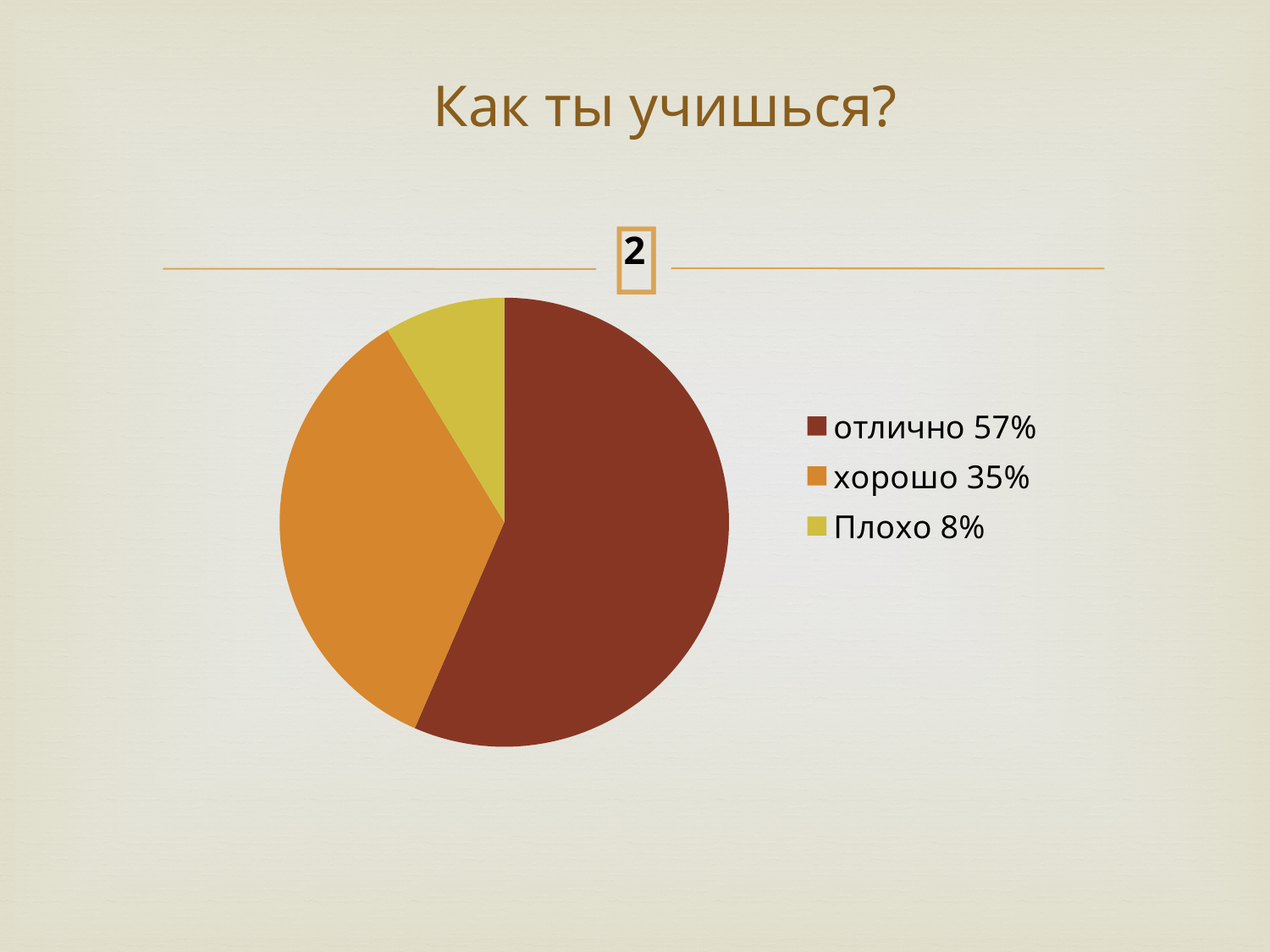
What colour is the slice for "Плохо"? yellow What is the difference in percentage points between "отлично" and "хорошо"? 22 How many slices does the pie chart have? 3 Which category has the smallest share of the pie? Плохо Which is larger, the share for "хорошо" or the share for "Плохо"? хорошо What percentage is shown for "отлично"? 57% What is the title of the slide containing the pie chart? Как ты учишься? Which category has the largest share of the pie? отлично What percentage is shown for "Плохо"? 8% What kind of chart is shown on the slide? pie chart What is the difference in percentage points between "хорошо" and "Плохо"? 27 What percentage is shown for "хорошо"? 35%